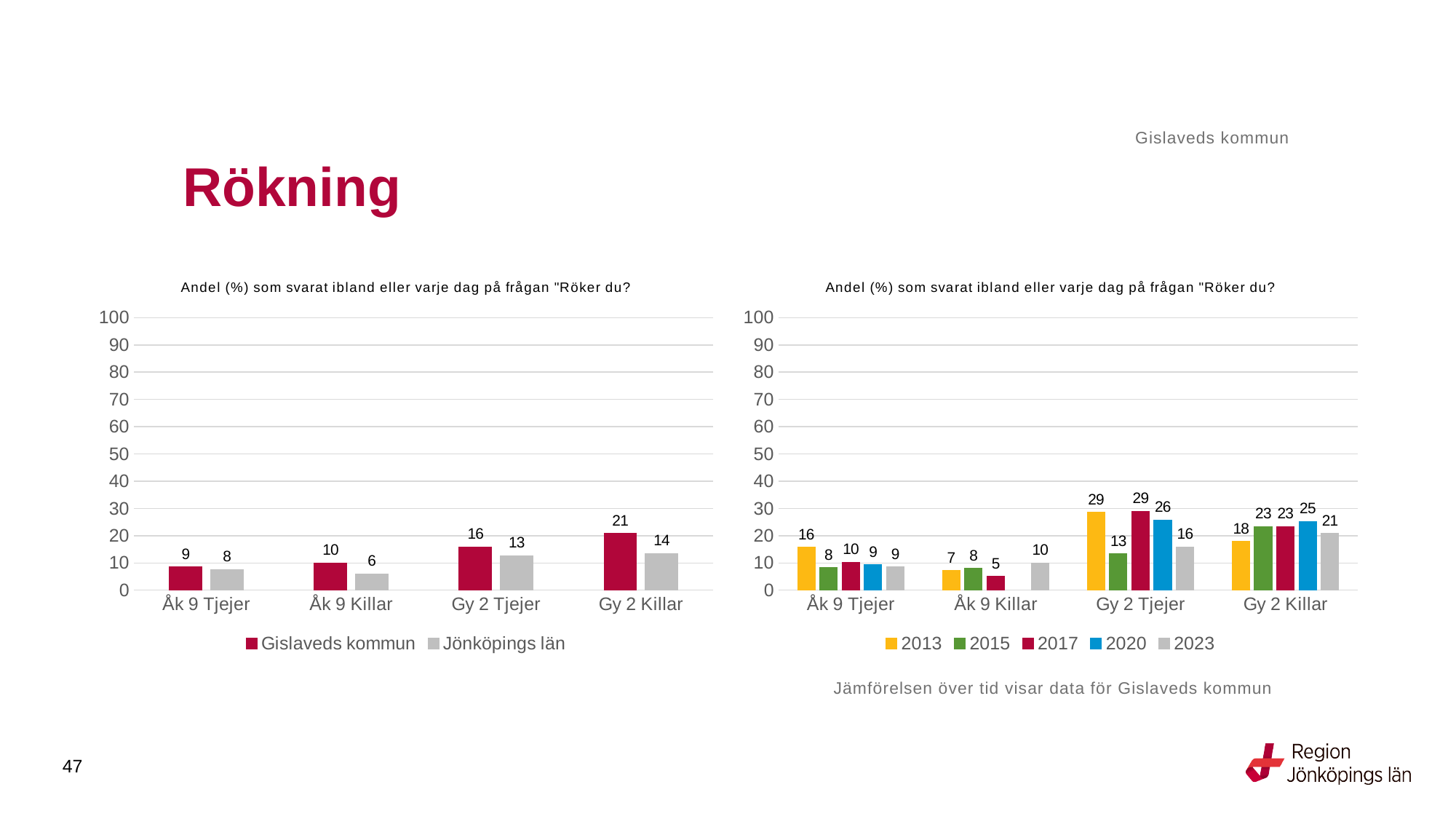
In the right chart, which year has the lowest value for Åk 9 Killar? 2017 In the left chart, what is the value for Jönköpings län for Åk 9 Killar? 6 What kind of chart is the left chart? Bar chart In the left chart, what is the value for Gislaveds kommun for Gy 2 Killar? 21 In the left chart, what is the difference between Gislaveds kommun and Jönköpings län for Gy 2 Killar? 7 In the right chart, how many series does the legend list? 5 In the left chart, which category has the highest value for Gislaveds kommun? Gy 2 Killar In the right chart, what is the difference between the 2013 and 2015 values for Gy 2 Tjejer? 16 In the right chart, what is the value for 2023 for Åk 9 Killar? 10 In the right chart, which is larger for Gy 2 Killar: the value for 2020 or the value for 2023? 2020 In the left chart, how many series does the legend list? 2 In the right chart, what is the value for 2013 for Gy 2 Tjejer? 29